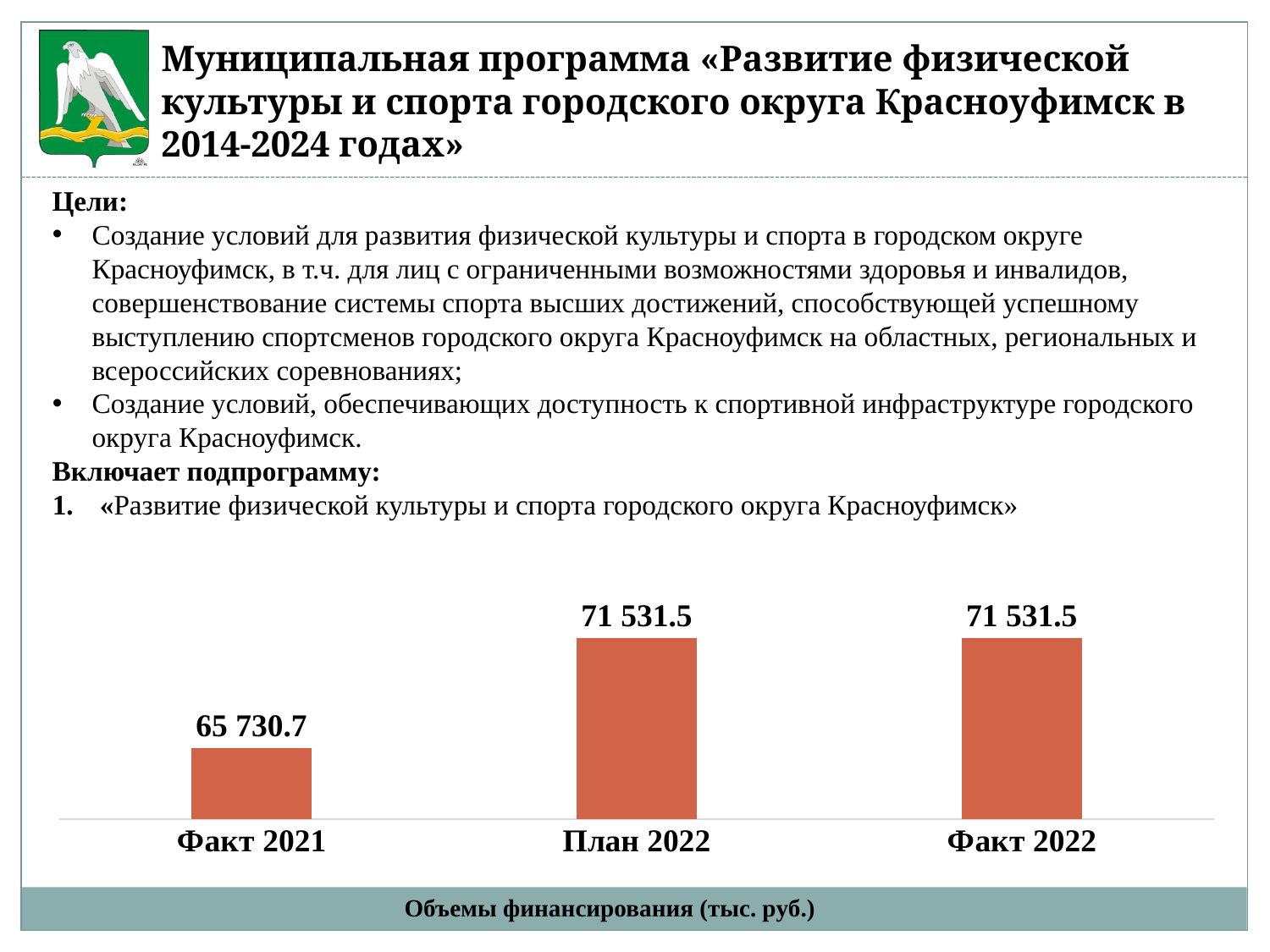
Does the value rise or fall from Факт 2021 to План 2022? rise Is the value for Факт 2022 larger than, smaller than, or the same as the value for План 2022? the same What is the difference between the values for План 2022 and Факт 2021? 5 800.8 What is the value for Факт 2022 on the chart? 71 531.5 What kind of chart is shown on the slide? bar chart In what units are the chart values given, according to the caption below the chart? тыс. руб. What is the value for План 2022 on the chart? 71 531.5 Which is larger, the value for Факт 2021 or the value for План 2022? План 2022 What is the caption shown below the chart? Объемы финансирования (тыс. руб.) How many categories are shown on the chart? 3 Which category has the lowest value on the chart? Факт 2021 What is the value for Факт 2021 on the chart? 65 730.7